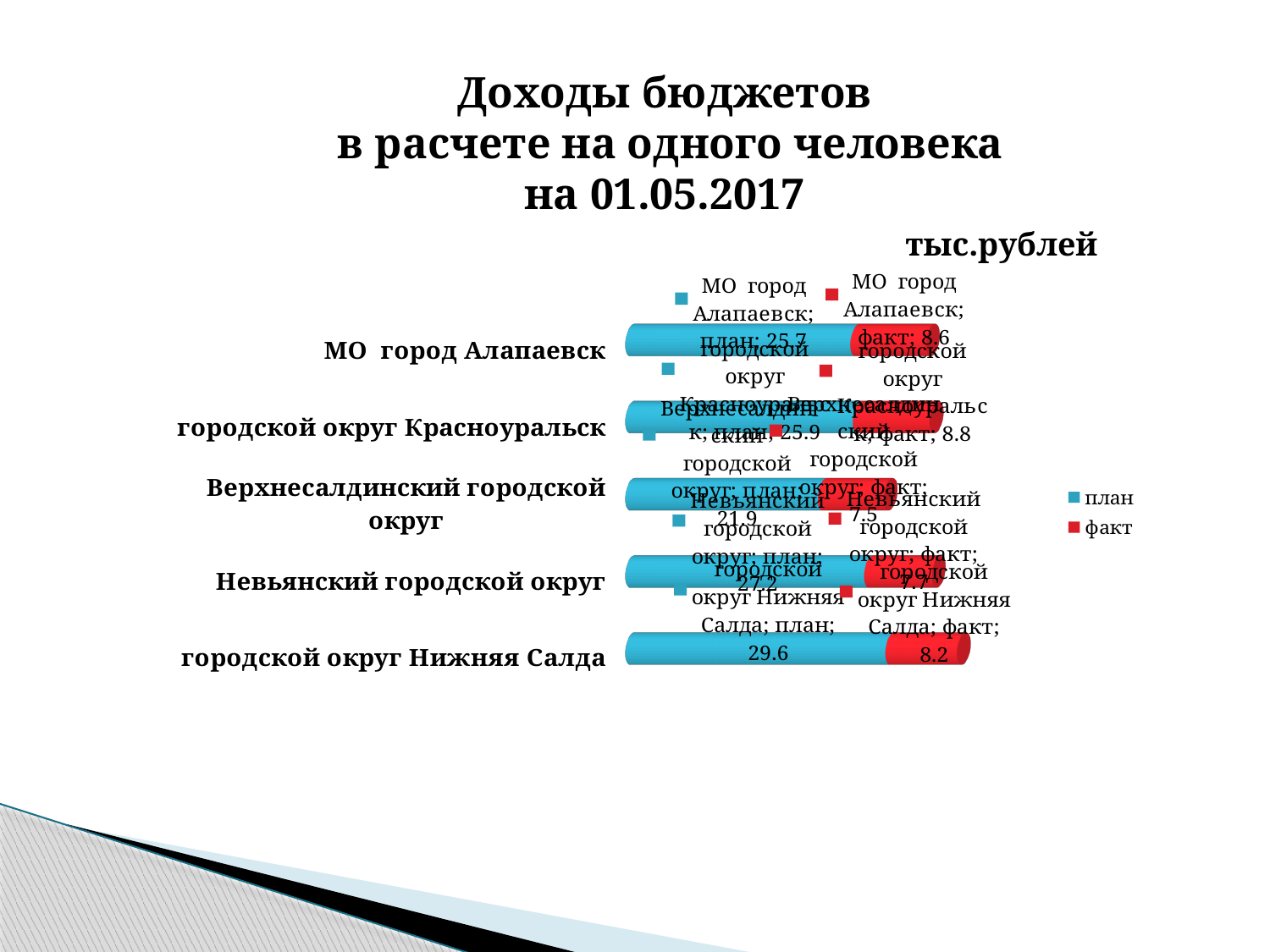
What is the план value for Верхнесалдинский городской округ? 21.9 How many series does the legend list? 2 What is the факт value for Невьянский городской округ? 7.7 What is the difference between the план and факт values for городской округ Красноуральск? 17.1 What is the факт value for МО город Алапаевск? 8.6 What is the total of the stacked bar for городской округ Нижняя Салда? 37.8 How many categories are shown in the chart? 5 Which category has the lowest факт value? Верхнесалдинский городской округ Which is larger, the план value for Невьянский городской округ or the план value for МО город Алапаевск? Невьянский городской округ Which category has the highest план value? городской округ Нижняя Салда What is the план value for городской округ Нижняя Салда? 29.6 What kind of chart is shown on the slide? bar chart